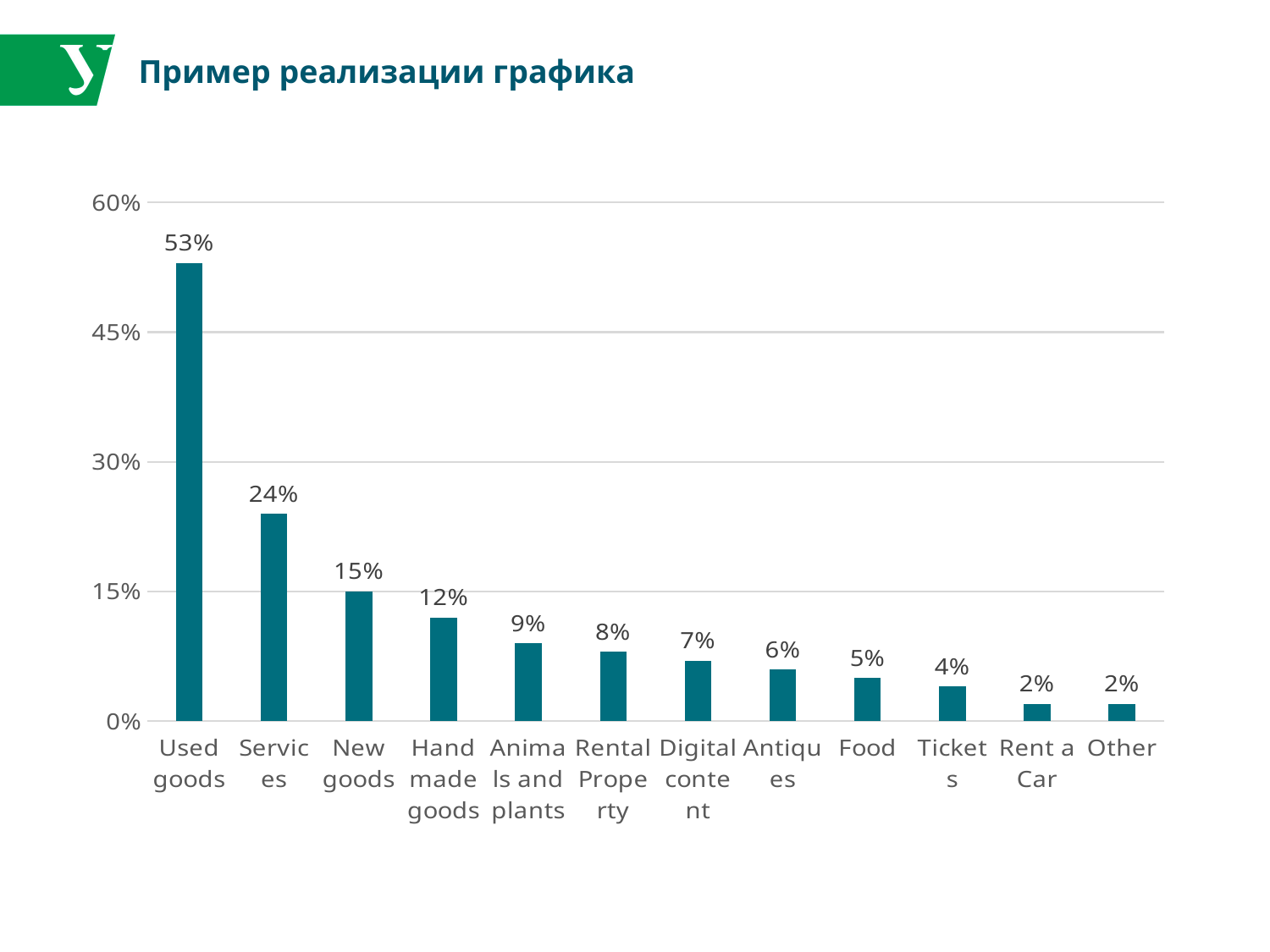
Do the values rise or fall from left to right along the x axis? fall Which category has the highest value? Used goods What is the value for Used goods? 53% What is the value for Animals and plants? 9% Is the value for Services greater or less than 30%? less What is the difference between the values for Used goods and Services? 29% What is the value for Food? 5% What is the difference between the values for New goods and Handmade goods? 3% How many categories are shown on the x axis? 12 Which is larger, the value for Rental Property or the value for Antiques? Rental Property What kind of chart is shown on the slide? bar chart What is the value for Services? 24%